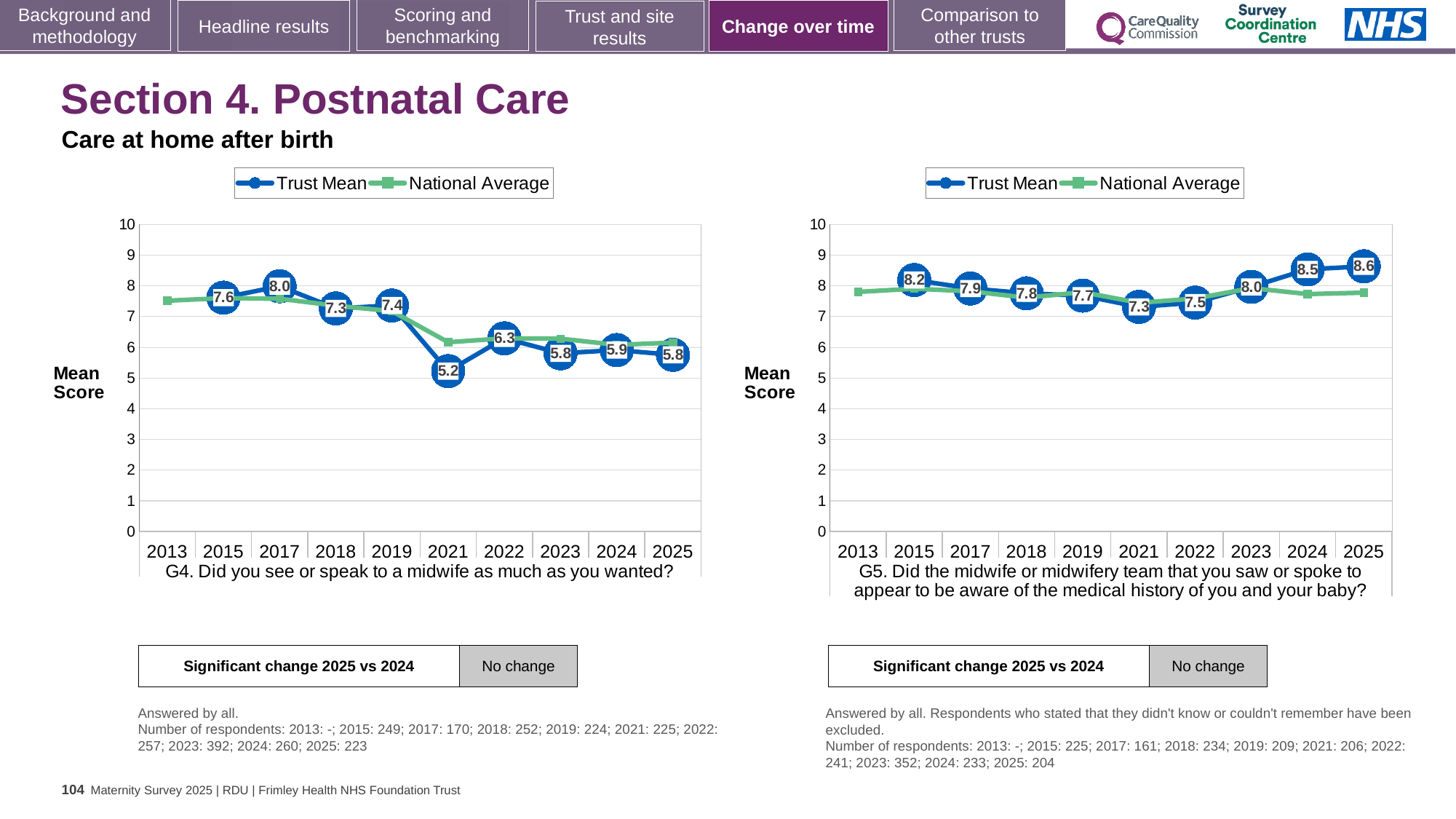
In the right chart (G5), which year has the lowest Trust Mean? 2021 In the left chart (G4), what is the difference between the Trust Mean in 2017 and in 2021? 2.8 How many series does the legend of the left chart (G4) list? 2 In the left chart (G4), what is the Trust Mean for 2021? 5.2 In the right chart (G5), is the National Average for 2025 greater or less than 8? less In the right chart (G5), what is the Trust Mean for 2024? 8.5 In the left chart (G4), what is the Trust Mean for 2025? 5.8 What type of chart is the right chart (G5)? Line chart In the left chart (G4), which year has the highest Trust Mean? 2017 In the right chart (G5), is the Trust Mean higher in 2015 or in 2019? 2015 In the right chart (G5), which year has the highest Trust Mean? 2025 In the left chart (G4), which year has the lowest Trust Mean? 2021